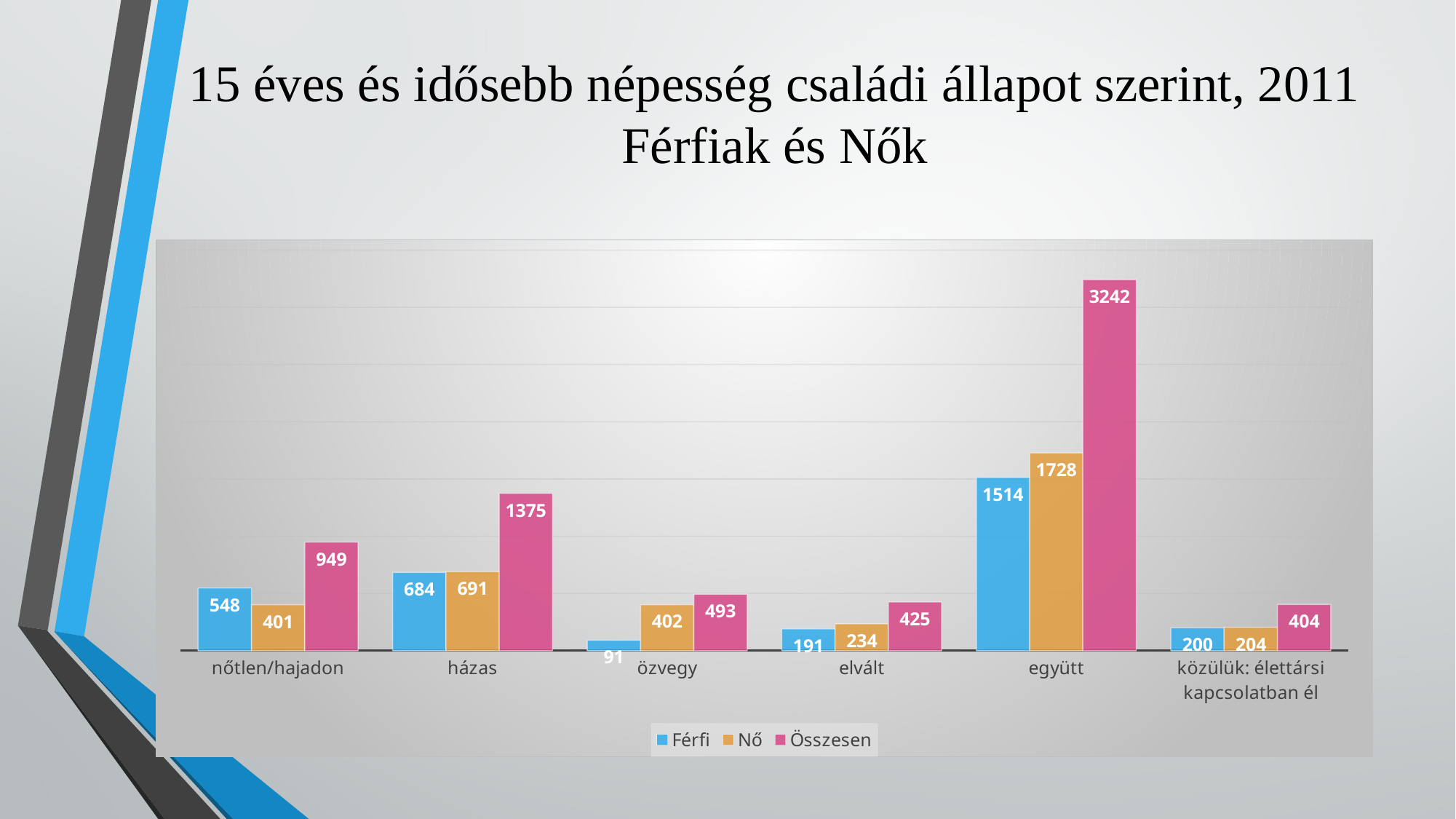
What is the difference between the Nő and Férfi values for the együtt category? 214 Which is larger for the nőtlen/hajadon category, the Férfi value or the Nő value? Férfi Which series is shown in pink in the legend? Összesen What kind of chart is shown on the slide? bar chart What is the Férfi value for the elvált category? 191 What is the Férfi value for the házas category? 684 What is the Összesen value for the együtt category? 3242 How many series does the legend list? 3 Which category has the lowest Férfi value? özvegy How many categories are shown on the x axis? 6 Which category has the highest Összesen value? együtt What is the Nő value for the özvegy category? 402